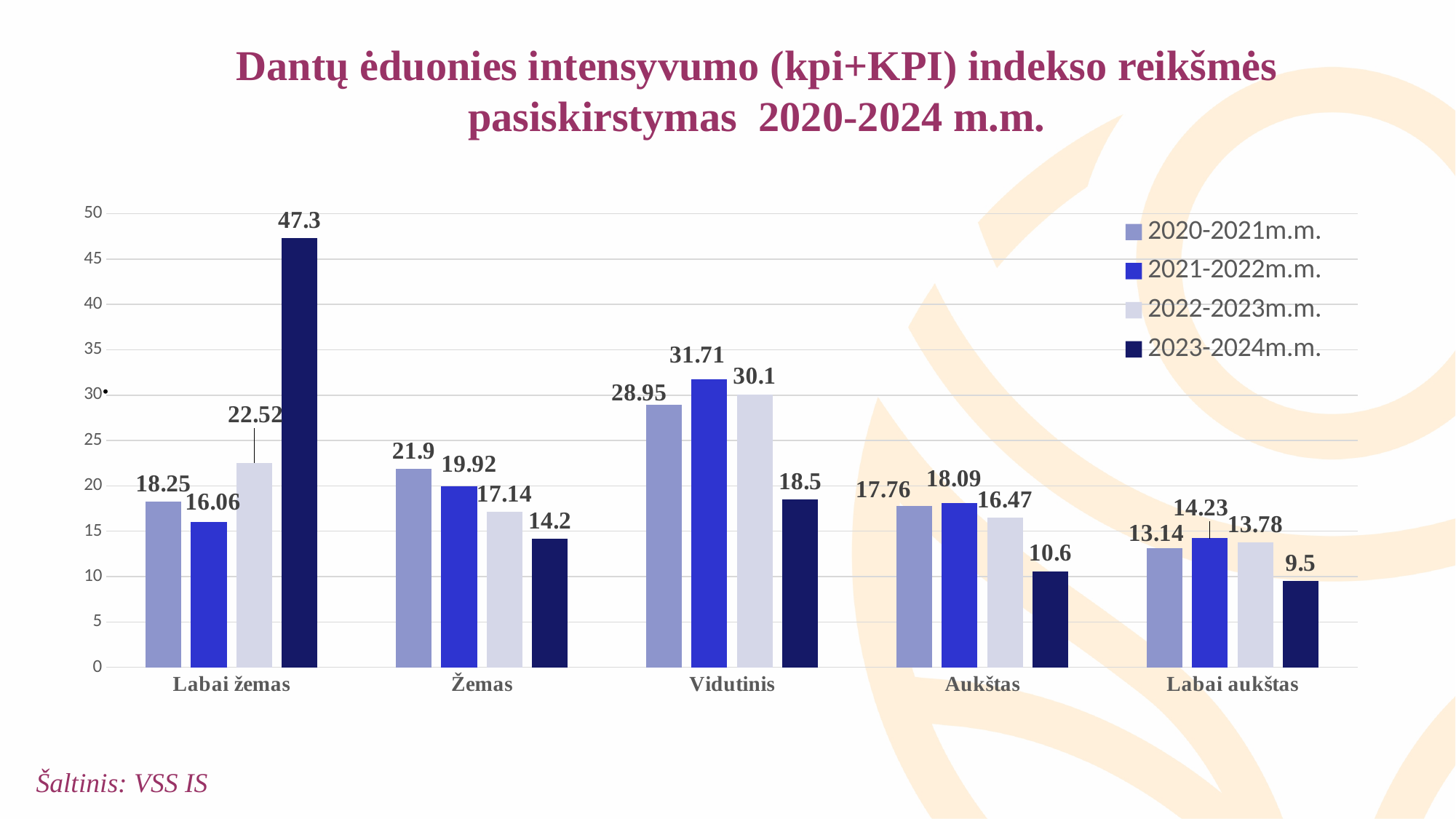
How many series does the legend list? 4 What is the value for Vidutinis in the 2021-2022m.m. series? 31.71 Is the value for Vidutinis in the 2022-2023m.m. series greater or less than 25? greater What is the value for Labai žemas in the 2023-2024m.m. series? 47.3 What is the value for Labai aukštas in the 2020-2021m.m. series? 13.14 Which category has the lowest value in the 2022-2023m.m. series? Labai aukštas Which category has the highest value in the 2023-2024m.m. series? Labai žemas What is the difference between the 2023-2024m.m. and 2020-2021m.m. values for Labai žemas? 29.05 How many categories are shown on the x axis? 5 What source is cited below the chart? VSS IS Which is larger for Aukštas: the 2020-2021m.m. value or the 2023-2024m.m. value? 2020-2021m.m. What kind of chart is shown on the slide? bar chart